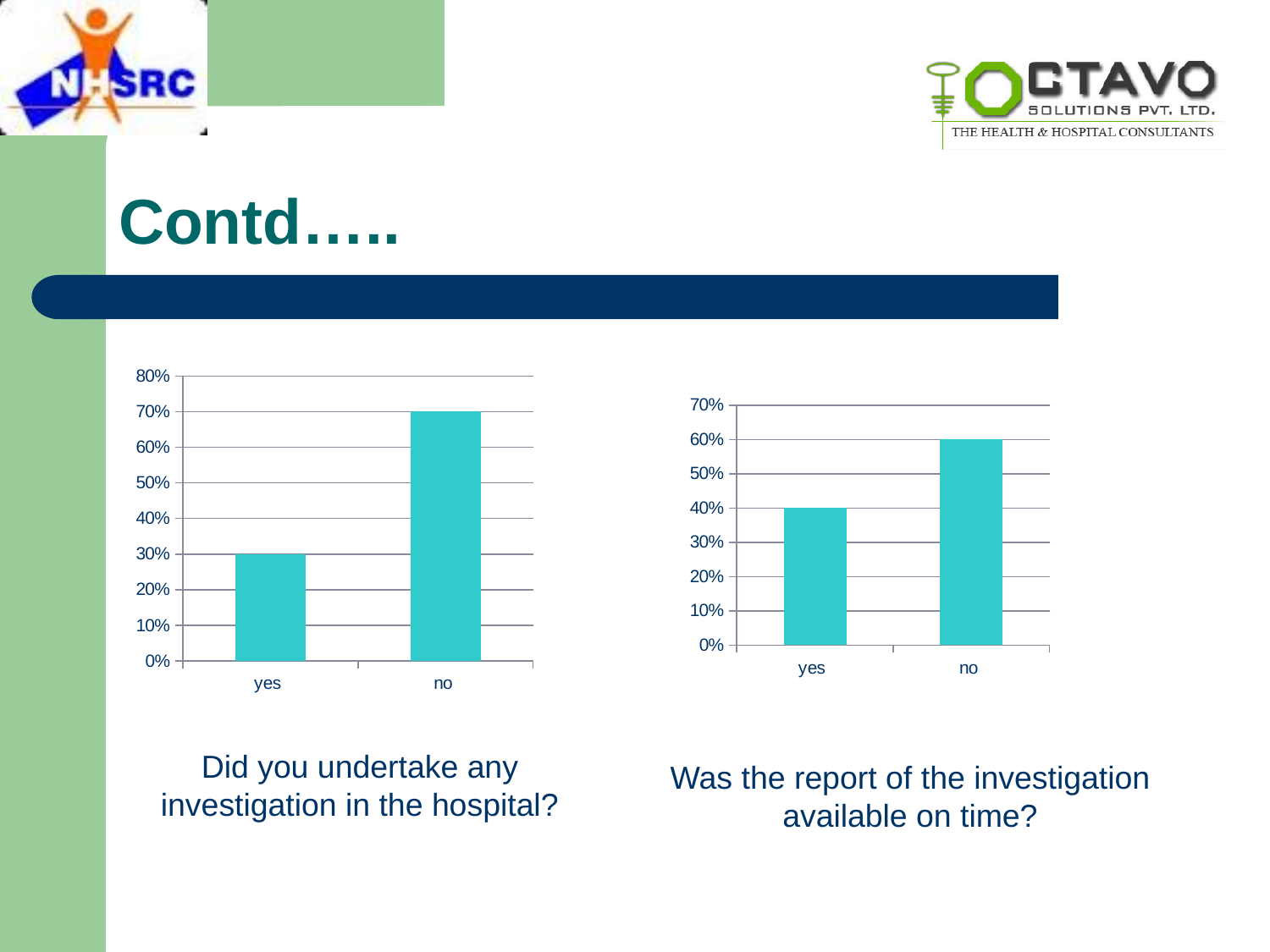
In the left chart (Did you undertake any investigation in the hospital?), which category has the highest value? no In the right chart (Was the report of the investigation available on time?), what is the value for "no"? 60% In the left chart (Did you undertake any investigation in the hospital?), what is the value for "no"? 70% What kind of chart is the right chart (Was the report of the investigation available on time?)? bar chart In the right chart (Was the report of the investigation available on time?), which is larger, the value for "yes" or the value for "no"? no In the left chart (Did you undertake any investigation in the hospital?), what is the difference between the values for "no" and "yes"? 40% In the right chart (Was the report of the investigation available on time?), what is the value for "yes"? 40% In the left chart (Did you undertake any investigation in the hospital?), what is the value for "yes"? 30% In the right chart (Was the report of the investigation available on time?), what is the difference between the values for "no" and "yes"? 20% How many categories are shown in the left chart (Did you undertake any investigation in the hospital?)? 2 What is the highest value shown on the vertical axis of the left chart (Did you undertake any investigation in the hospital?)? 80% In the right chart (Was the report of the investigation available on time?), which category has the lowest value? yes